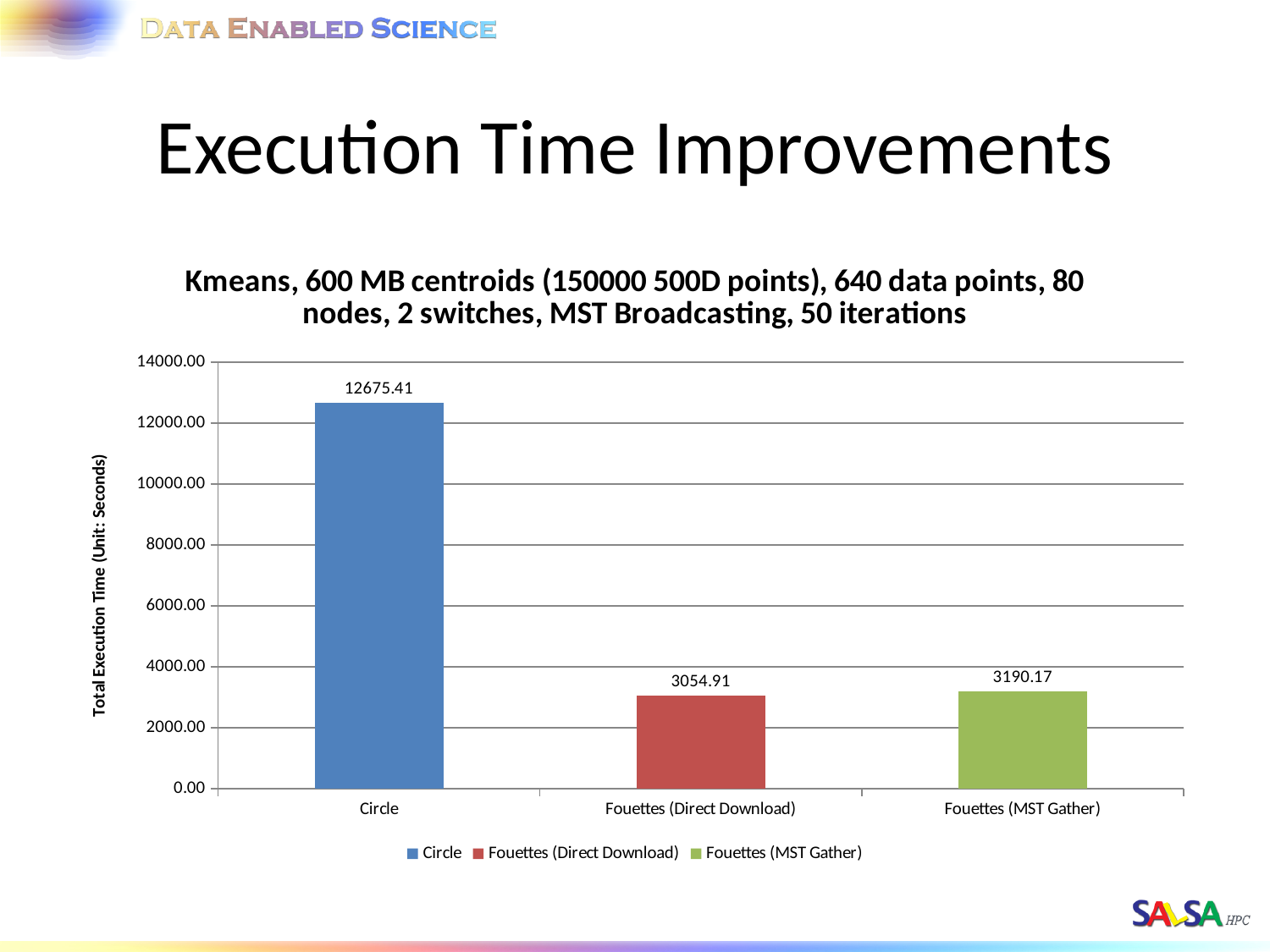
Is the value for Circle greater or less than 12000.00? greater What is the total execution time for Circle? 12675.41 What is the difference in execution time between Fouettes (MST Gather) and Fouettes (Direct Download)? 135.26 What kind of chart is shown on the slide? bar chart Which category has the lowest total execution time? Fouettes (Direct Download) What is the total execution time for Fouettes (MST Gather)? 3190.17 How many categories are shown on the x axis? 3 Which category has the highest total execution time? Circle Which has a larger execution time, Fouettes (Direct Download) or Fouettes (MST Gather)? Fouettes (MST Gather) What is the total execution time for Fouettes (Direct Download)? 3054.91 What is the difference in execution time between Circle and Fouettes (Direct Download)? 9620.50 What is the label of the y axis? Total Execution Time (Unit: Seconds)